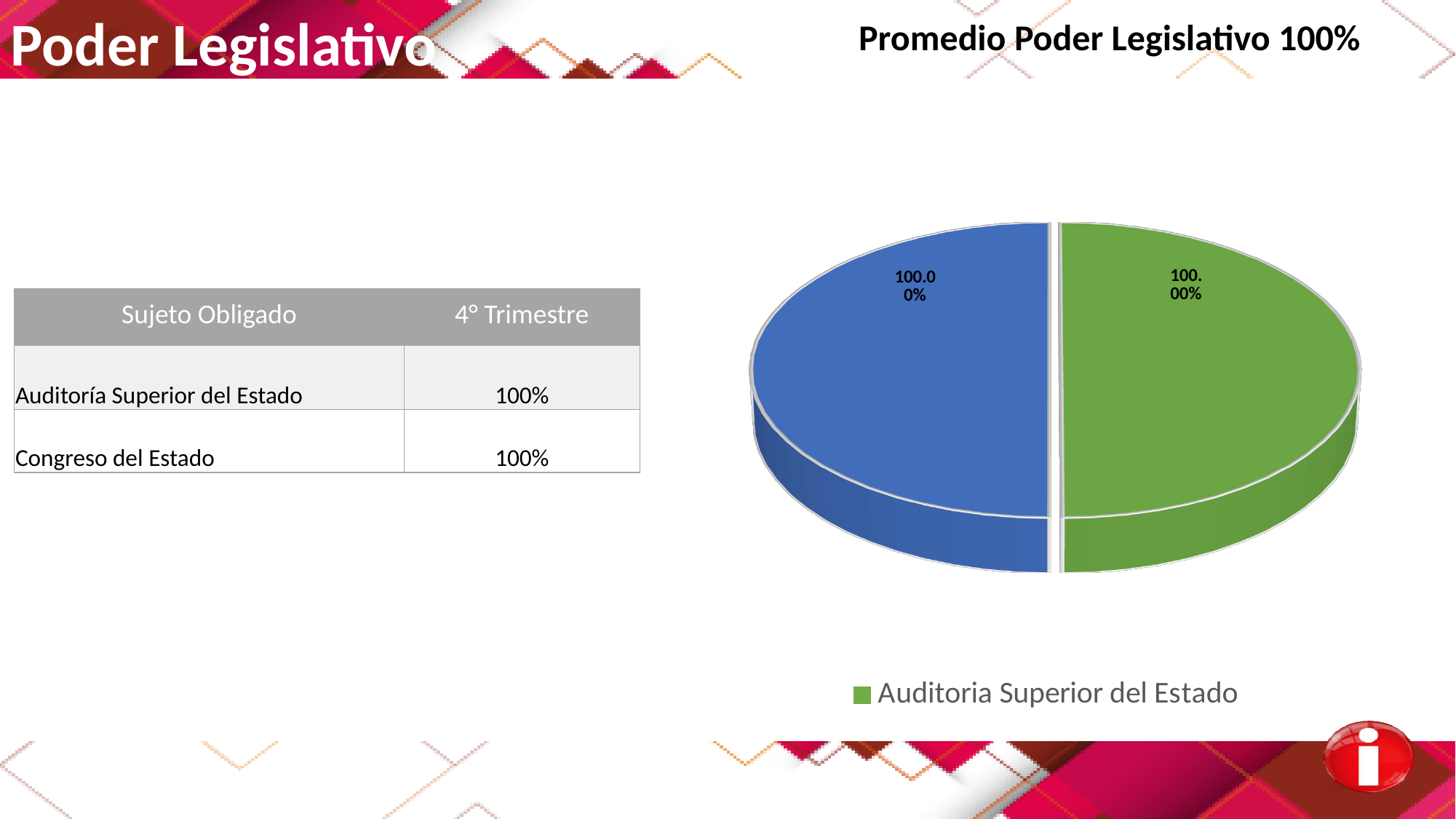
What value is printed on the green slice (Auditoria Superior del Estado) of the pie chart? 100.00% What is the difference between the values printed on the green slice and the blue slice of the pie chart? 0.00% What is the title shown above the pie chart? Promedio Poder Legislativo 100% How many entries does the pie chart's legend list? 1 How many slices does the pie chart have? 2 Which colour represents Auditoria Superior del Estado in the pie chart's legend? green What kind of chart is shown on the slide? pie chart What value is printed on the blue slice of the pie chart? 100.00% Do the two slices of the pie chart show the same printed value? Yes